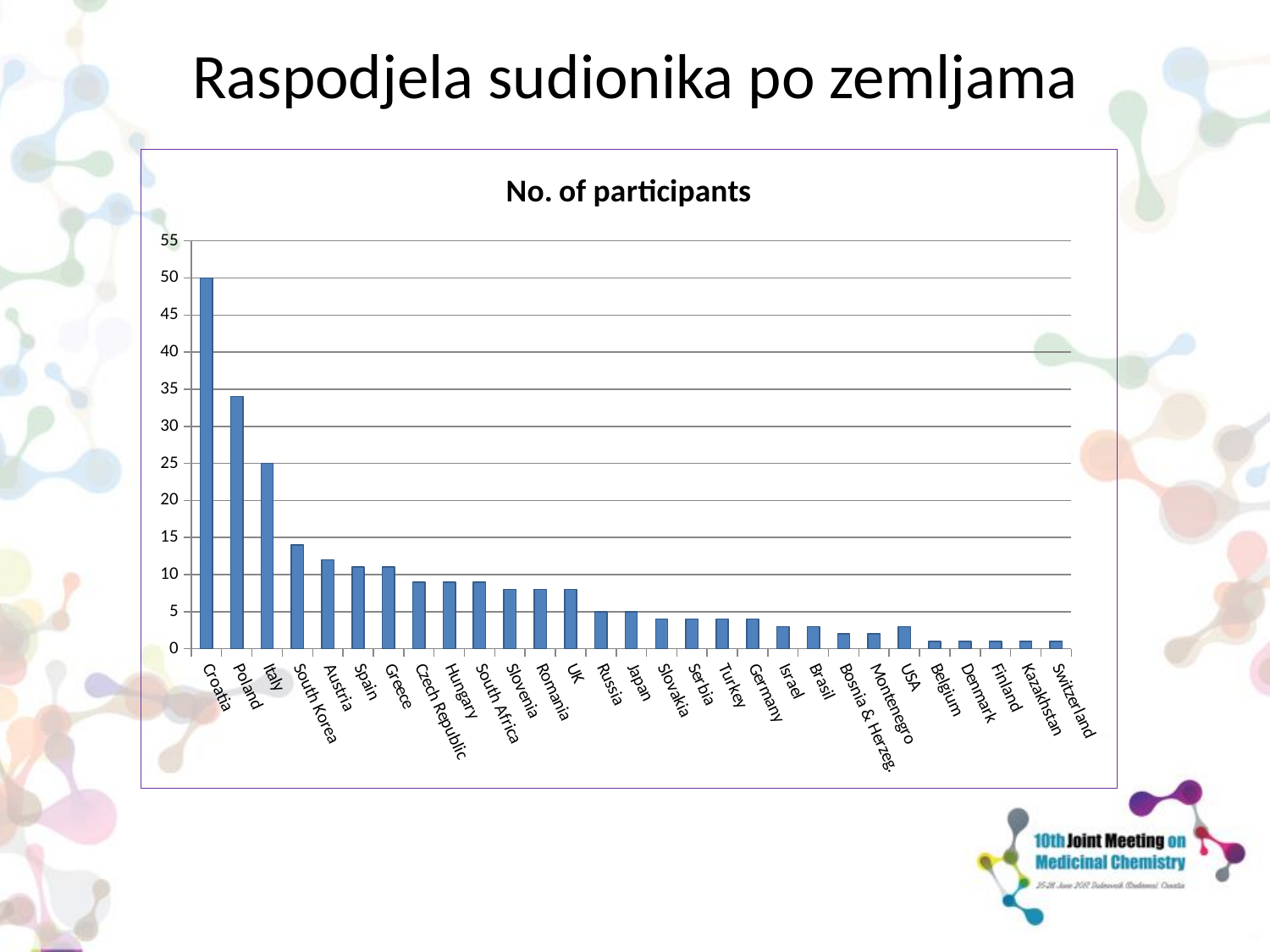
What is the title of the chart? No. of participants Is the value for South Korea greater or less than 10? greater What is the number of participants for Italy? 25 What is the number of participants for Croatia? 50 Is the value for Poland greater or less than 30? greater Which country has the highest number of participants? Croatia What kind of chart is shown on the slide? bar chart Which has more participants, Poland or Italy? Poland What is the difference in participants between Croatia and Italy? 25 Is the value for Czech Republic greater or less than 10? less How many countries are shown on the x axis? 29 Do the values rise or fall moving from left to right along the x axis? fall